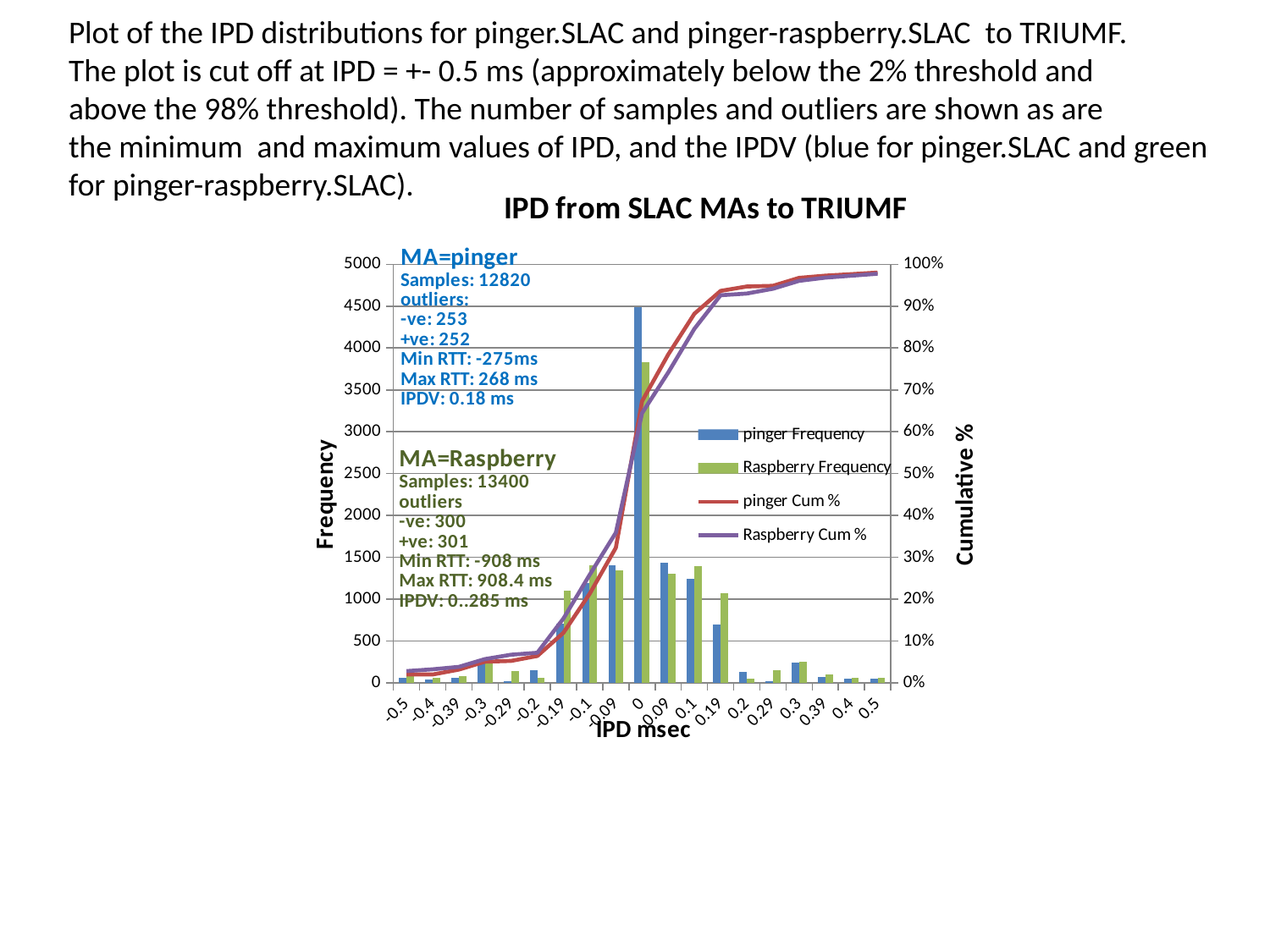
How many IPD categories are shown along the x axis of the chart? 19 Is the pinger Frequency at IPD 0 greater or less than 4000? greater At IPD 0.19, which is larger: the pinger Frequency or the Raspberry Frequency? Raspberry Frequency At IPD 0, which is larger: the pinger Frequency or the Raspberry Frequency? pinger Frequency At which IPD value is the Raspberry Frequency bar highest? 0 What is the label of the right-hand vertical axis of the chart? Cumulative % Is the Raspberry Frequency at IPD 0 greater or less than 4000? less At which IPD value is the pinger Frequency bar highest? 0 Do the pinger Cum % and Raspberry Cum % lines rise or fall as IPD increases along the x axis? rise What is the title of the chart? IPD from SLAC MAs to TRIUMF What kind of chart is "IPD from SLAC MAs to TRIUMF"? A combined bar and line chart How many series does the legend of the "IPD from SLAC MAs to TRIUMF" chart list? 4